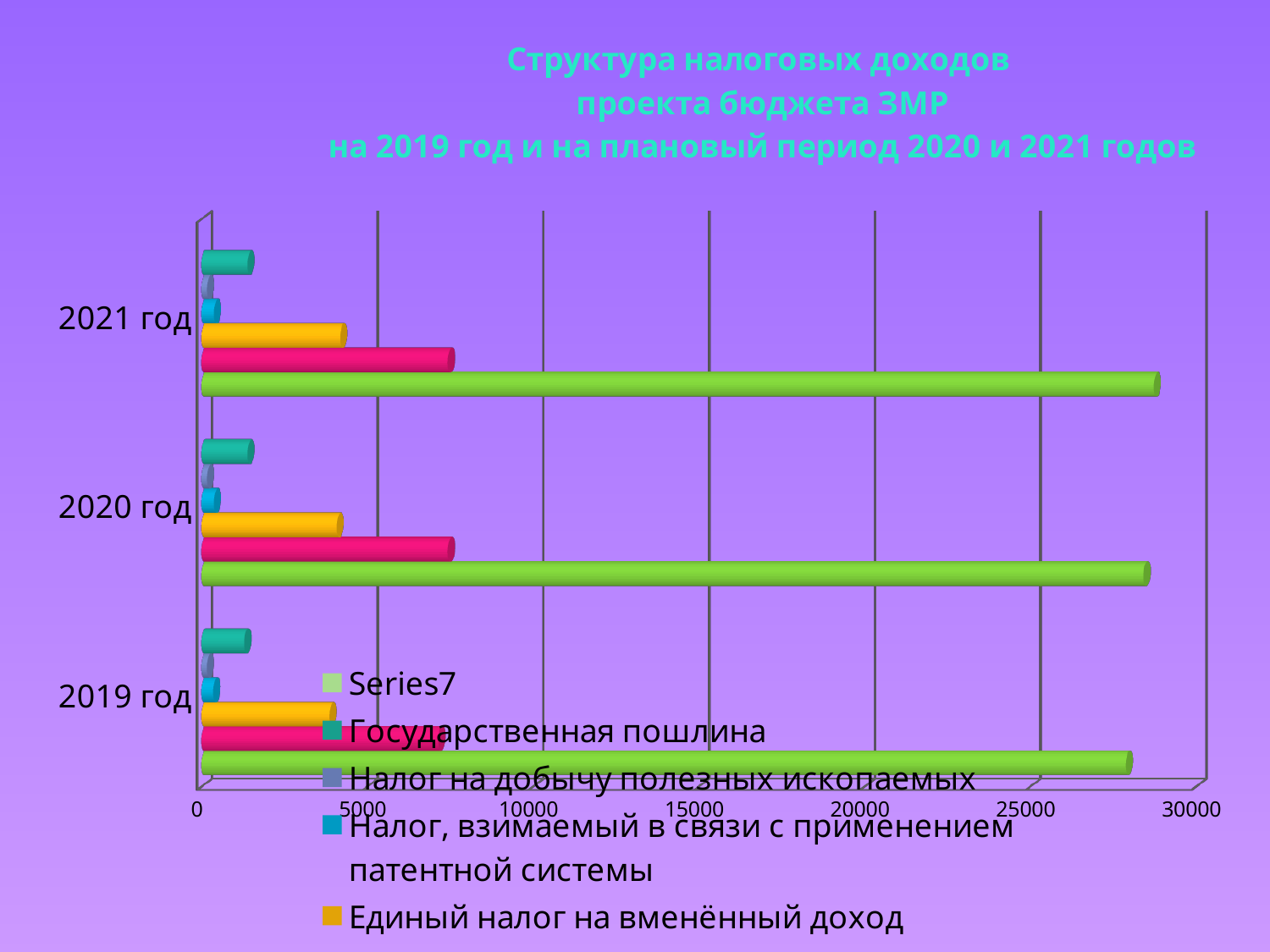
How many year categories are shown on the vertical axis of the chart? 3 For 2019 год, which is larger: Государственная пошлина or Единый налог на вменённый доход? Единый налог на вменённый доход Is the value of Государственная пошлина for 2020 год greater or less than 5000? less What is the highest value shown on the horizontal axis of the chart? 30000 Is the value of Единый налог на вменённый доход for 2019 год greater or less than 5000? less What kind of chart is shown on the slide? bar chart